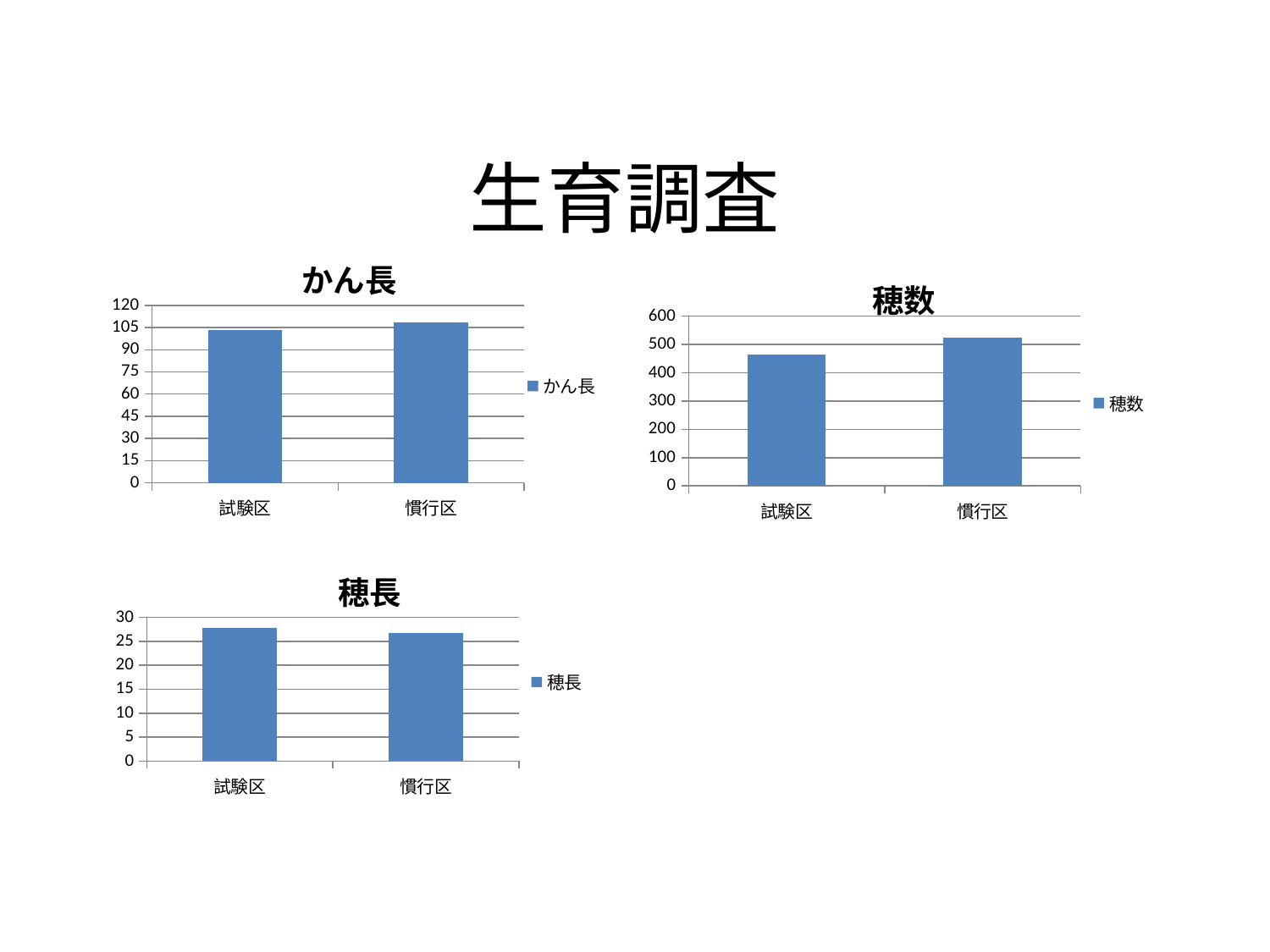
In the 穂数 chart, is the value for 慣行区 greater or less than 500? greater How many series does the legend of the かん長 chart list? 1 In the かん長 chart, which category has the higher value, 試験区 or 慣行区? 慣行区 In the 穂数 chart, is the value for 試験区 greater or less than 500? less How many categories are shown on the x axis of the 穂数 chart? 2 In the かん長 chart, is the value for 慣行区 greater or less than 105? greater How many charts are shown on the slide? 3 In the 穂数 chart, which category has the higher value? 慣行区 What kind of chart is the 穂長 chart? bar chart